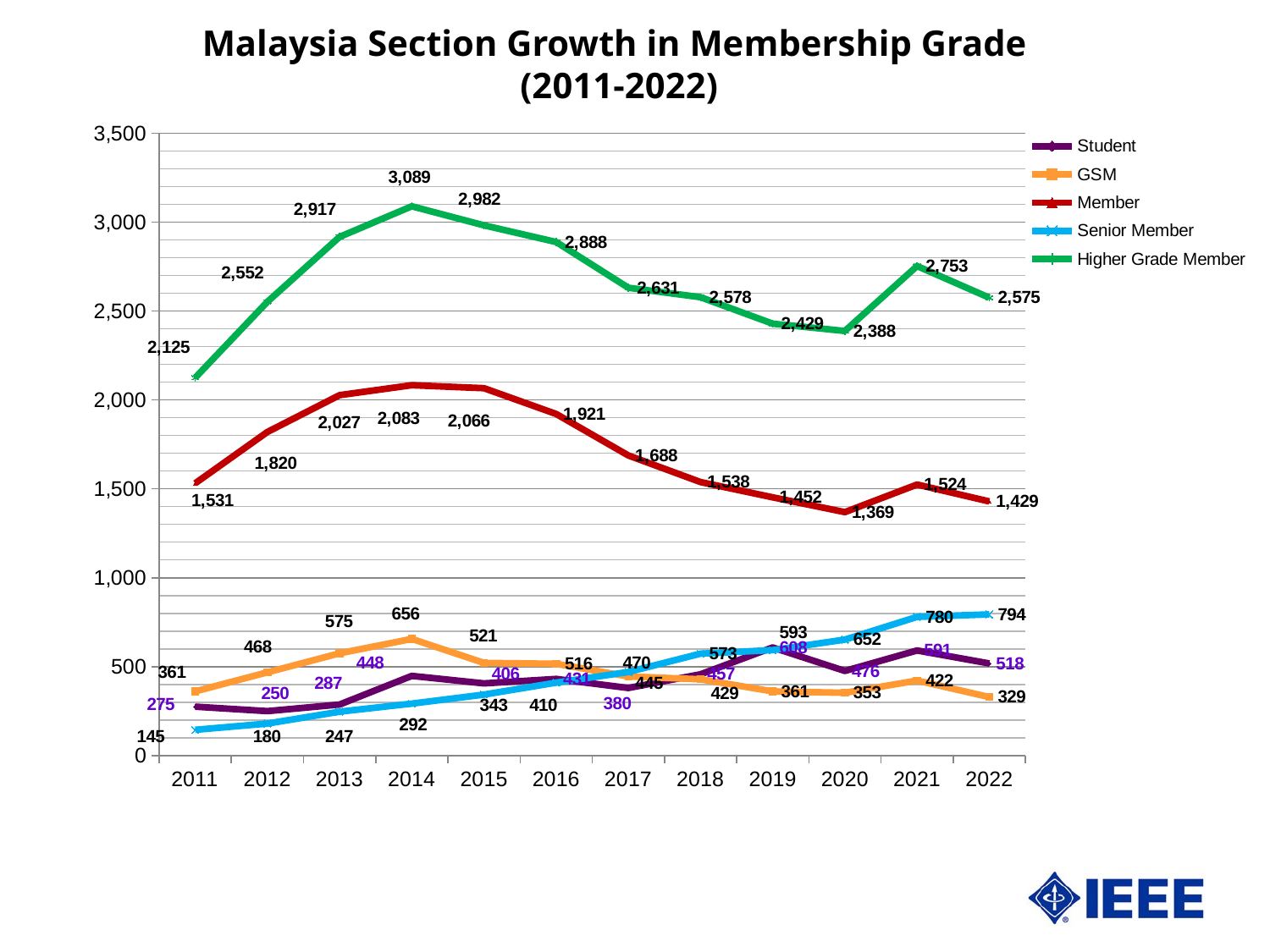
In which year is the Higher Grade Member value highest? 2014 What is the Member value for 2011? 1,531 What is the difference between the Higher Grade Member values for 2021 and 2022? 178 Does the Senior Member series rise or fall from 2011 to 2022? rises Is the Member value for 2014 greater or less than 2,000? greater What is the Higher Grade Member value for 2014? 3,089 How many years are plotted along the x axis? 12 In which year is the Member value lowest? 2020 What is the Senior Member value for 2011? 145 How many series does the legend list? 5 What kind of chart is shown on the slide? line chart In 2022, which is larger: Senior Member or GSM? Senior Member